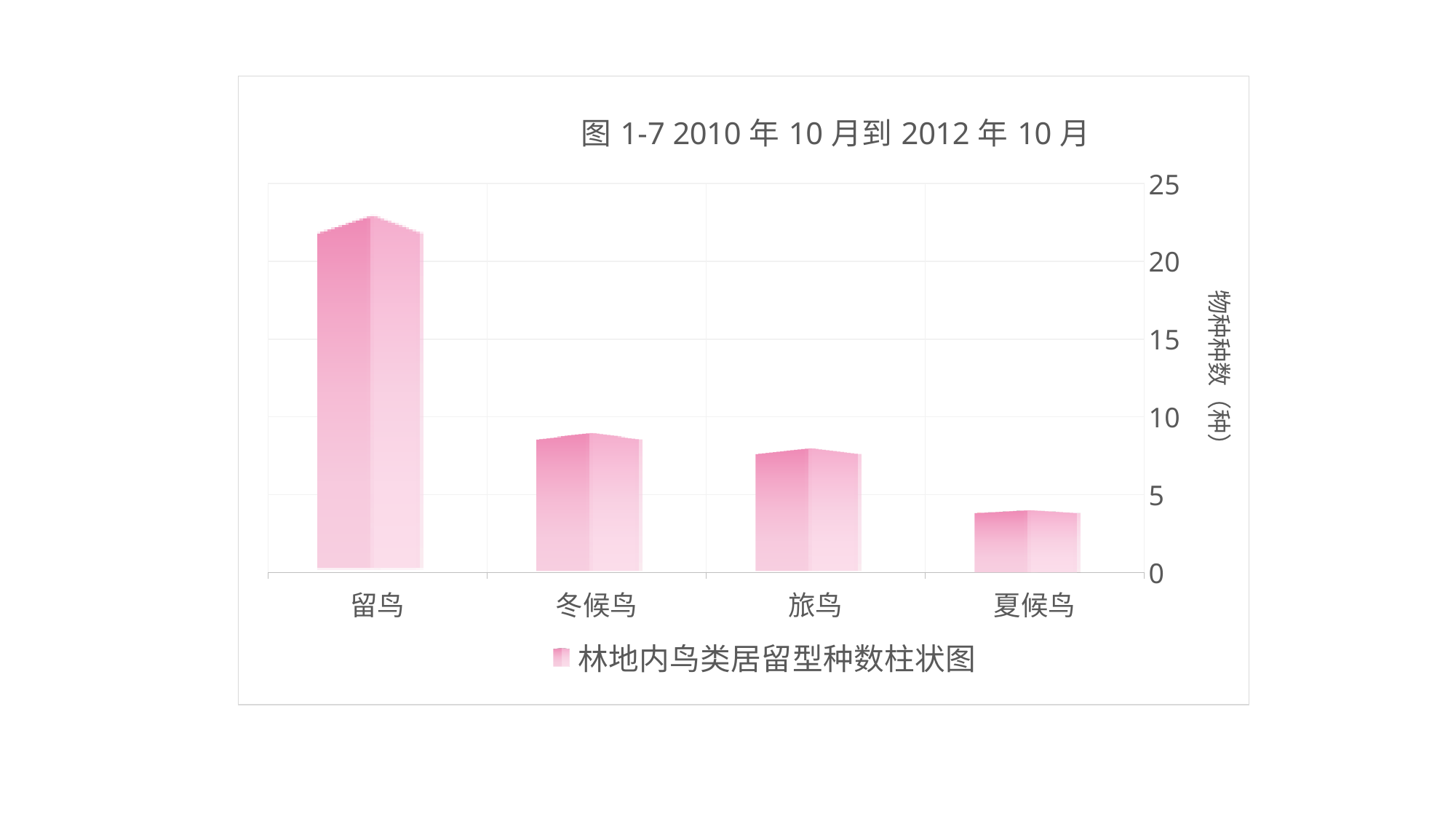
Is the value for 旅鸟 greater or less than 5? greater Which category has the lowest value in the chart? 夏候鸟 What kind of chart is shown on the slide? bar chart How many series does the chart's legend list? 1 Do the values rise or fall moving from left to right along the x axis? fall What is the label of the vertical axis of the chart? 物种种数（种） Which is larger, the value for 留鸟 or the value for 冬候鸟? 留鸟 Is the value for 夏候鸟 greater or less than 5? less Is the value for 留鸟 greater or less than 20? greater How many categories are shown on the x axis of the chart? 4 Which category has the highest value in the chart? 留鸟